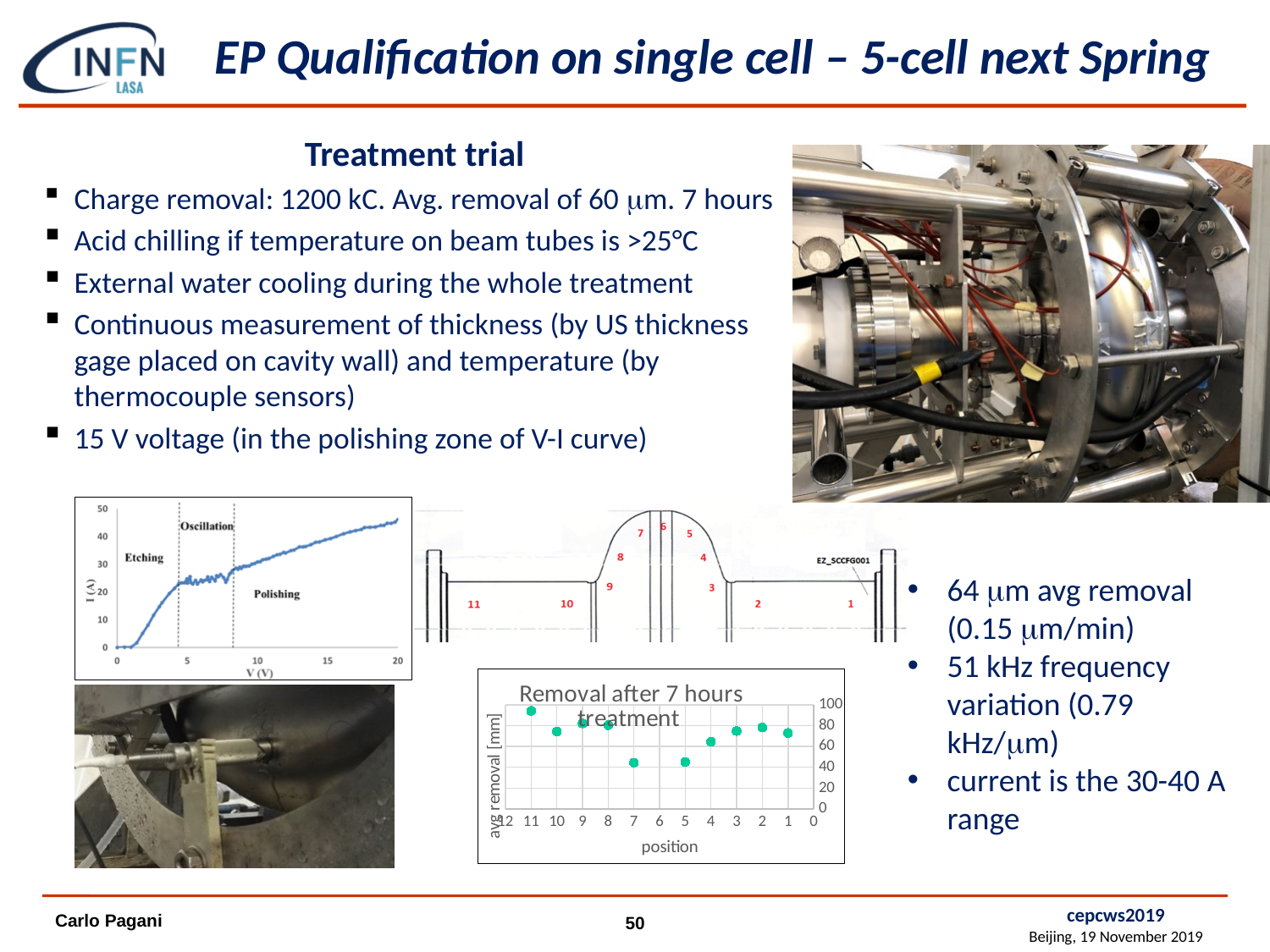
In the chart titled "Removal after 7 hours treatment", is the value for position 4 greater or less than 40? greater In the chart titled "Removal after 7 hours treatment", what is the label of the x axis? position In the chart titled "Removal after 7 hours treatment", how many data points are plotted? 10 In the chart titled "Removal after 7 hours treatment", which is larger, the value for position 5 or the value for position 2? position 2 In the chart titled "Removal after 7 hours treatment", which position has the highest avg removal? 11 In the chart titled "Removal after 7 hours treatment", is the value for position 7 greater or less than 60? less In the chart titled "Removal after 7 hours treatment", what kind of chart is it? scatter chart In the chart titled "Removal after 7 hours treatment", is the value for position 11 greater or less than 80? greater In the chart titled "Removal after 7 hours treatment", which is larger, the value for position 11 or the value for position 7? position 11 In the chart titled "Removal after 7 hours treatment", what is the label of the y axis? avg removal [mm]